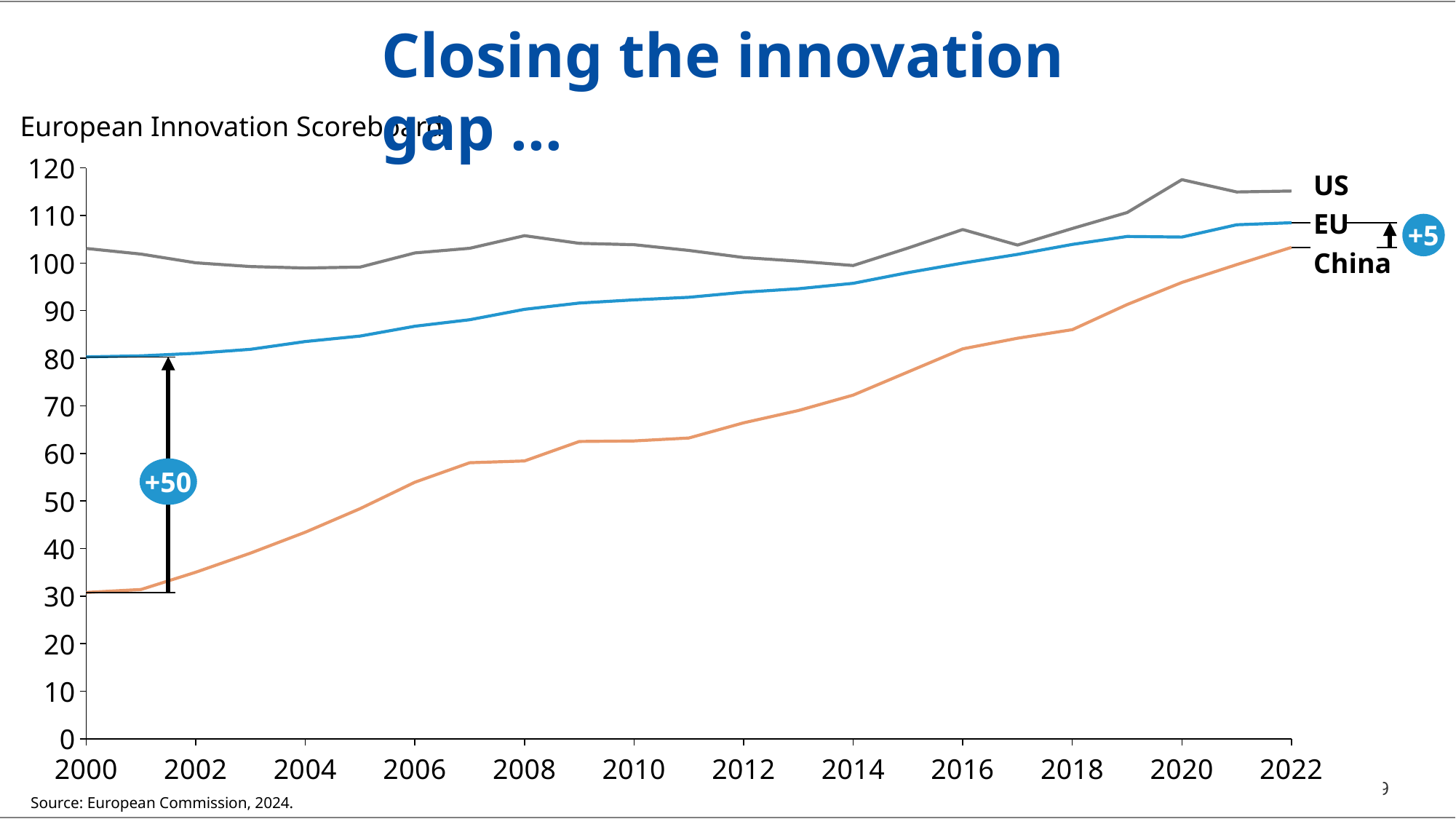
Which series has the lowest value in 2000? China Which series has the highest value in 2022? US Is the value for China in 2010 greater or less than 70? less Is the value for China in 2000 greater or less than 40? less Does the China series rise or fall from 2000 to 2022? Rise Is the value for US in 2000 greater or less than 100? greater Which is larger in 2022, the value for US or the value for EU? US What kind of chart is shown on the slide? Line chart How many series are plotted on the chart? 3 What gap between EU and China is annotated on the chart for 2000? +50 What is the title of the chart? European Innovation Scoreboard